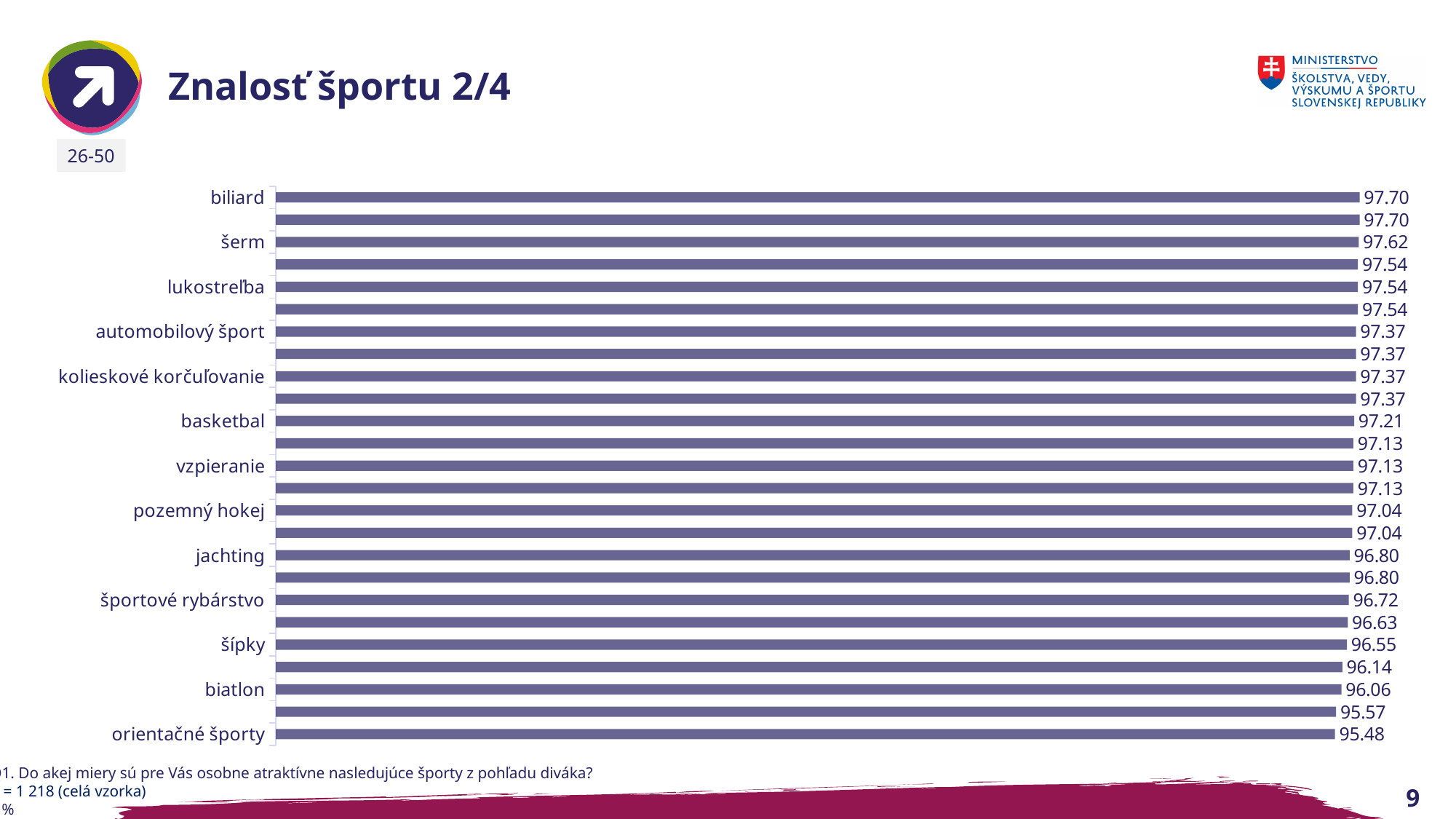
What is the value for šerm? 97.62 What is the highest value shown on the chart? 97.70 What is the value for kolieskové korčuľovanie? 97.37 What is the title of the slide? Znalosť športu 2/4 Which has a larger value, šerm or šípky? šerm Which labelled category has the lowest value? orientačné športy What type of chart is shown on the slide? bar chart How many bars are plotted on the chart? 25 What is the value for orientačné športy? 95.48 What is the value for jachting? 96.80 What is the value for biliard? 97.70 What is the difference between the values for biliard and orientačné športy? 2.22